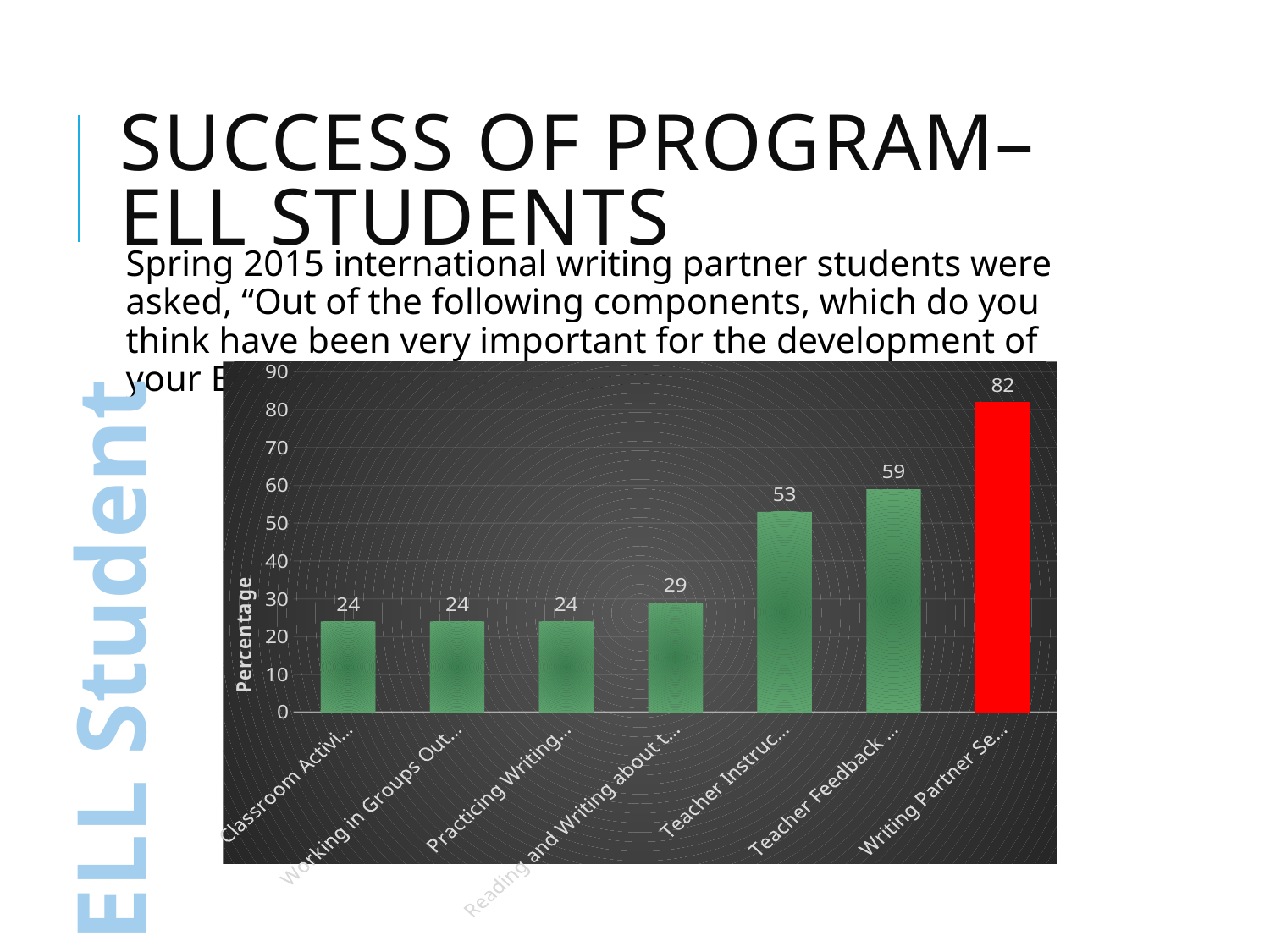
Which bar is coloured red rather than green? Writing Partner Se... What is the value of the bar labelled 'Teacher Instruc...'? 53 What type of chart is shown on the slide? bar chart Which is larger, the value for 'Teacher Instruc...' or the value for 'Teacher Feedback ...'? Teacher Feedback ... What is the value of the bar labelled 'Writing Partner Se...'? 82 What is the label of the vertical axis? Percentage What is the difference between the 'Writing Partner Se...' bar and the 'Teacher Feedback ...' bar? 23 How many bars (categories) are plotted in the chart? 7 Which category has the highest value in the chart? Writing Partner Se... Is the value for 'Teacher Instruc...' greater or less than 50? greater What is the value of the bar labelled 'Teacher Feedback ...'? 59 What is the value of the bar labelled 'Reading and Writing about t...'? 29